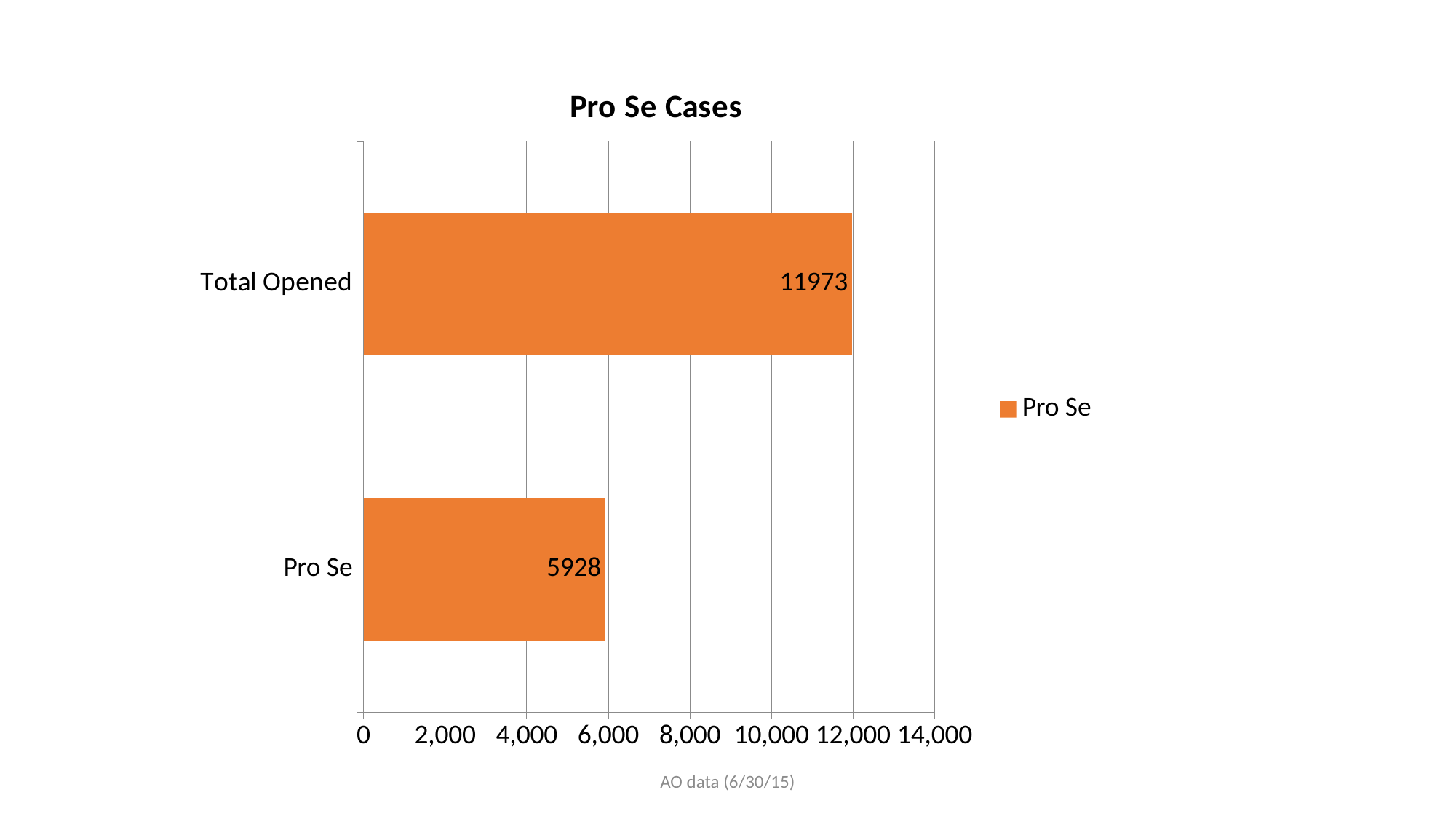
Which is larger, the value for Total Opened or the value for Pro Se? Total Opened What is the difference between the Total Opened value and the Pro Se value? 6045 What kind of chart is shown? bar chart What is the title of the chart? Pro Se Cases Is the value for Pro Se greater or less than 6,000? less What is the value for Pro Se? 5928 How many categories are shown in the chart? 2 How many series does the legend list? 1 Which category has the highest value? Total Opened Is the value for Total Opened greater or less than 10,000? greater What is the value for Total Opened? 11973 Which category has the lowest value? Pro Se